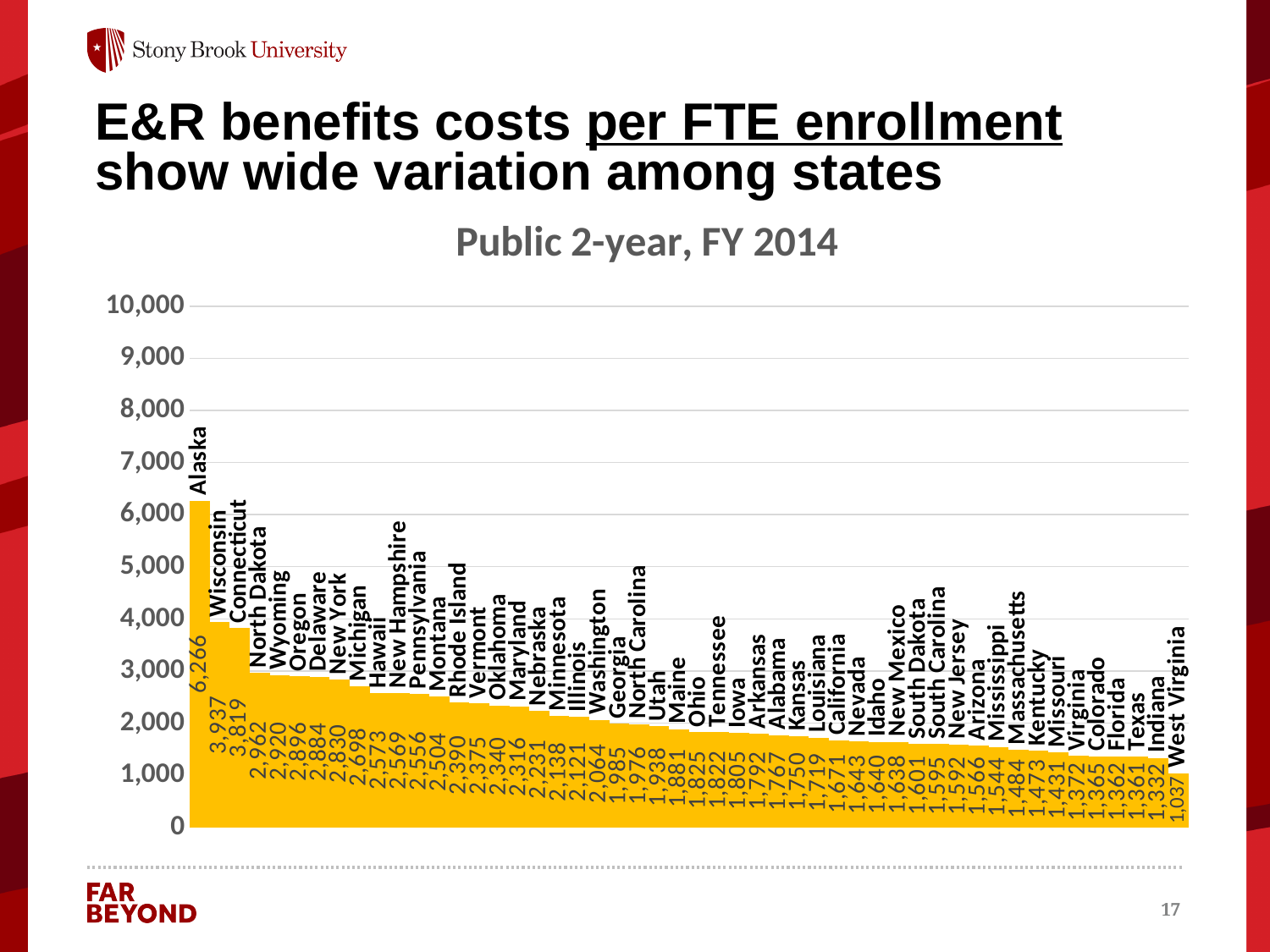
Which state has the lowest value? West Virginia Which state has the highest value? Alaska Which is larger, the value for Wisconsin or the value for Connecticut? Wisconsin Is the value for Alaska greater or less than 6,000? greater What is the title of the chart? Public 2-year, FY 2014 What is the value for Alaska? 6,266 What is the value for New York? 2,830 How many states are plotted in the chart? 50 Do the values rise or fall from left to right along the x axis? fall What is the difference between the values for Alaska and Wisconsin? 2,329 What is the value for West Virginia? 1,037 What kind of chart is shown on the slide? bar chart